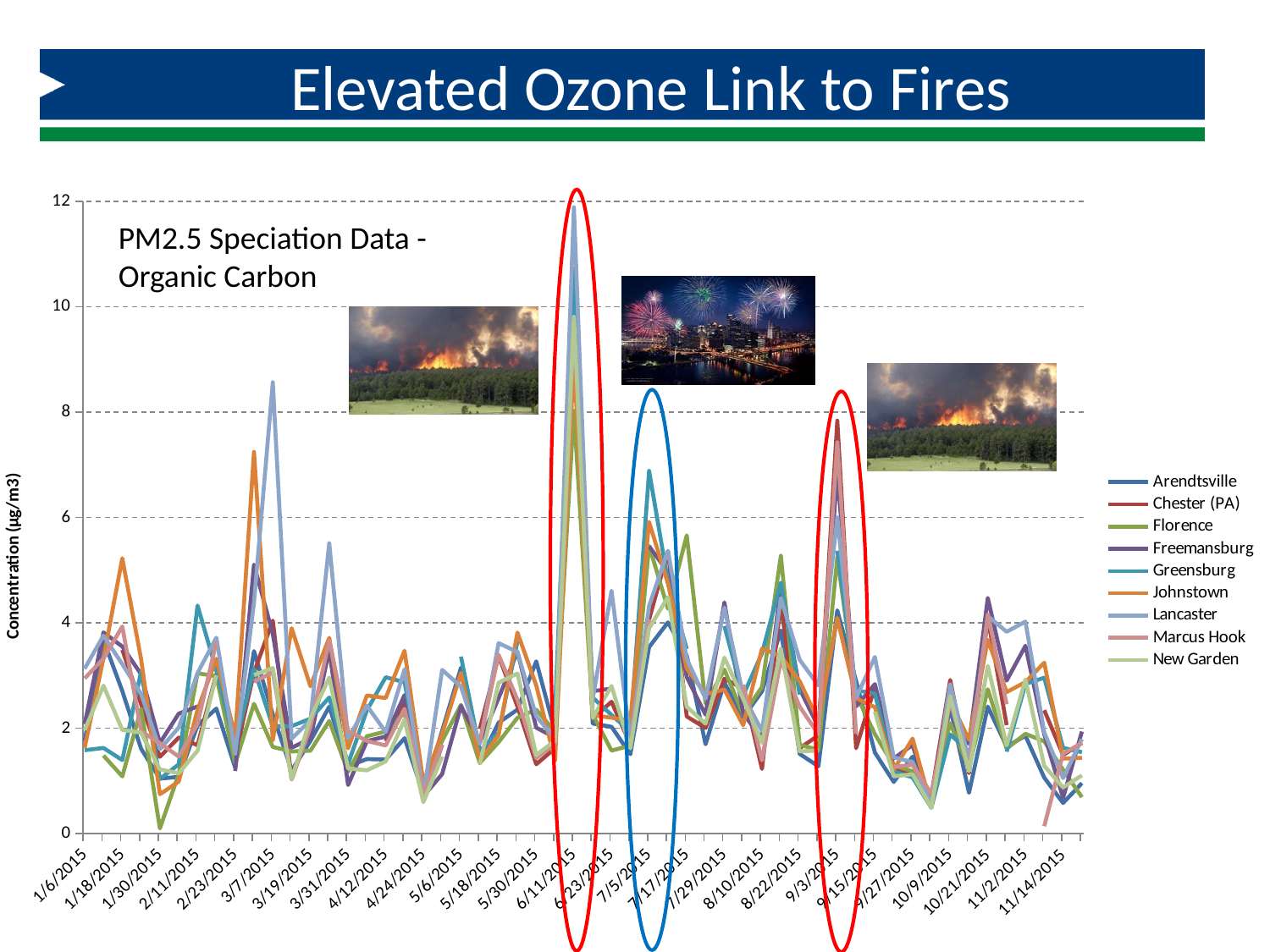
What kind of chart is shown on the slide? line chart Around which x-axis date does the highest peak on the chart occur? 6/11/2015 Is the peak value for Lancaster near 3/7/2015 greater or less than 8? greater Which is larger for Lancaster: its peak near 6/11/2015 or its peak near 3/7/2015? its peak near 6/11/2015 What is the label on the vertical axis of the chart? Concentration (µg/m3) Is the peak value for Marcus Hook near 9/3/2015 greater or less than 6? greater What title text is printed inside the chart area? PM2.5 Speciation Data - Organic Carbon Is the peak value for Lancaster near 6/11/2015 greater or less than 10? greater Which series reaches the highest value anywhere on the chart? Lancaster How many series does the legend list? 9